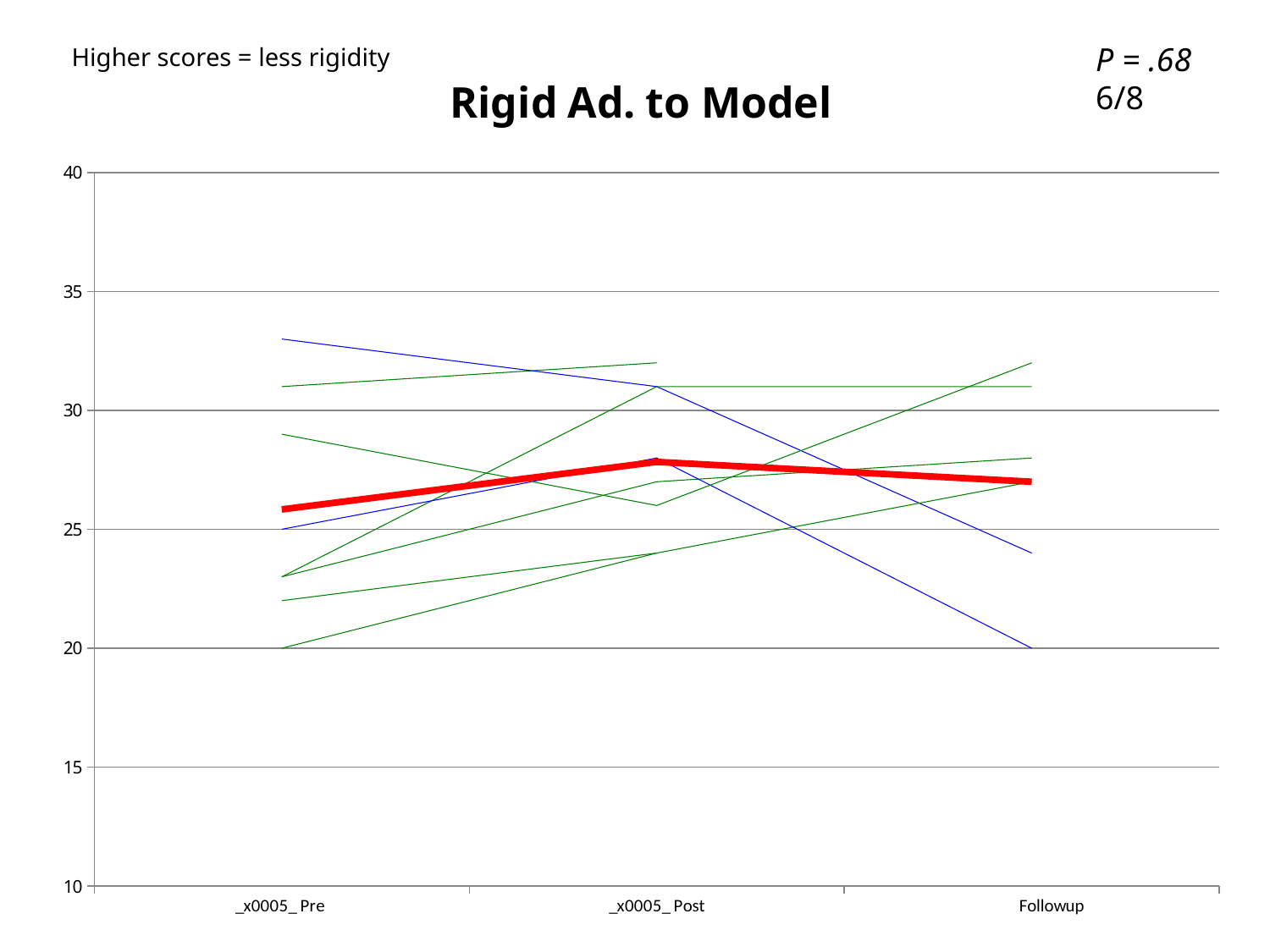
What is the lowest value plotted at Followup? 20 Is the value of the thick red line at _x0005_ Post greater or less than 30? less What is the title of the chart? Rigid Ad. to Model What is the lowest value plotted at _x0005_ Pre? 20 What is the maximum value shown on the y axis? 40 How many categories are shown on the x axis of the chart? 3 Does the thick red line rise or fall from _x0005_ Pre to _x0005_ Post? rise Is the highest line at _x0005_ Pre greater or less than 30? greater What kind of chart is shown on the slide? line chart What is the P value printed on the slide? P = .68 Is the value of the thick red line at Followup greater or less than 25? greater Does the thick red line rise or fall from _x0005_ Post to Followup? fall